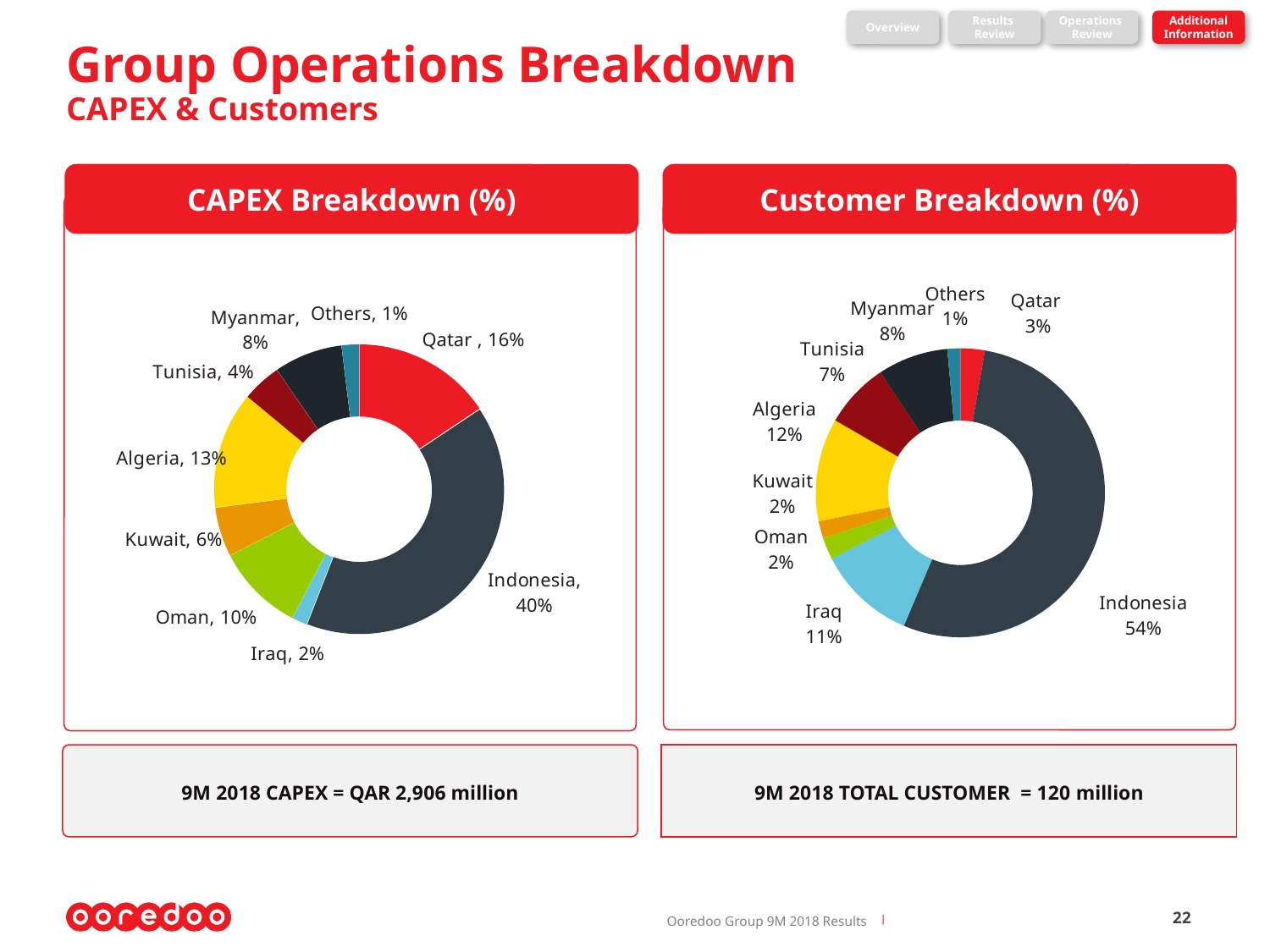
How many categories are shown in the Customer Breakdown (%) chart? 9 What total CAPEX figure for 9M 2018 is stated below the CAPEX Breakdown chart? QAR 2,906 million In the Customer Breakdown (%) chart, which category has the smallest share? Others In the CAPEX Breakdown (%) chart, which is larger, Myanmar or Kuwait? Myanmar In the Customer Breakdown (%) chart, what share does Indonesia have? 54% In the CAPEX Breakdown (%) chart, which category has the largest share? Indonesia In the Customer Breakdown (%) chart, which is larger, Algeria or Tunisia? Algeria In the CAPEX Breakdown (%) chart, what is the value for Algeria? 13% What type of chart is the CAPEX Breakdown (%) chart? Pie chart (doughnut) In the CAPEX Breakdown (%) chart, what share does Indonesia have? 40% In the Customer Breakdown (%) chart, what is the value for Iraq? 11% In the CAPEX Breakdown (%) chart, what is the difference between Qatar's share and Oman's share? 6%